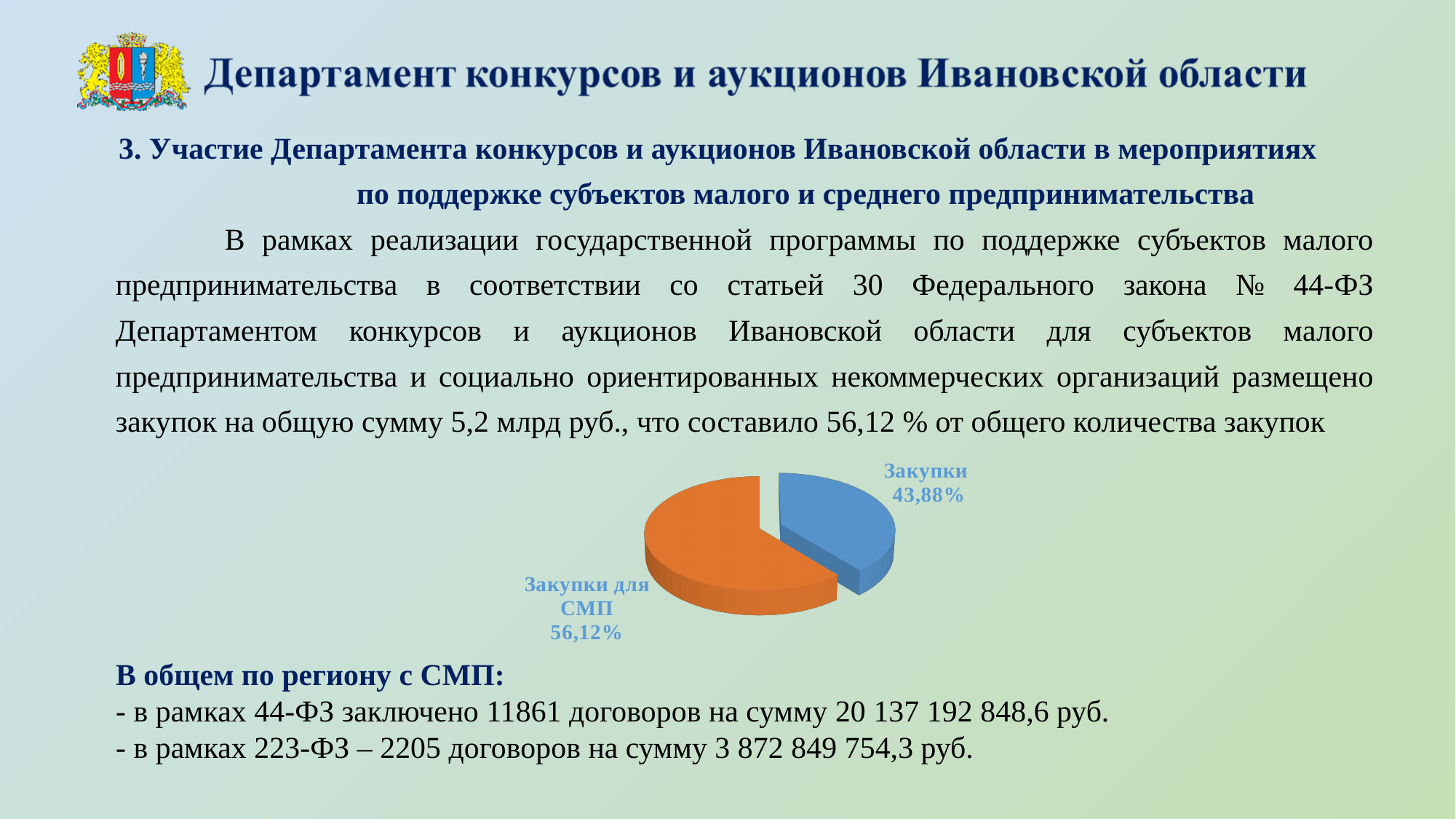
What colour is the "Закупки" slice in the pie chart? blue What colour is the "Закупки для СМП" slice in the pie chart? orange How many slices does the pie chart have? 2 Which is larger: the "Закупки" slice or the "Закупки для СМП" slice? Закупки для СМП Is the share for "Закупки" greater or less than 50%? less Which slice of the pie chart is the largest? Закупки для СМП What is the difference in percentage points between the "Закупки для СМП" slice and the "Закупки" slice? 12,24 What share of the pie does the slice labelled "Закупки для СМП" represent? 56,12% What kind of chart is shown on the slide? pie chart Which slice of the pie chart is the smallest? Закупки What share of the pie does the slice labelled "Закупки" represent? 43,88%